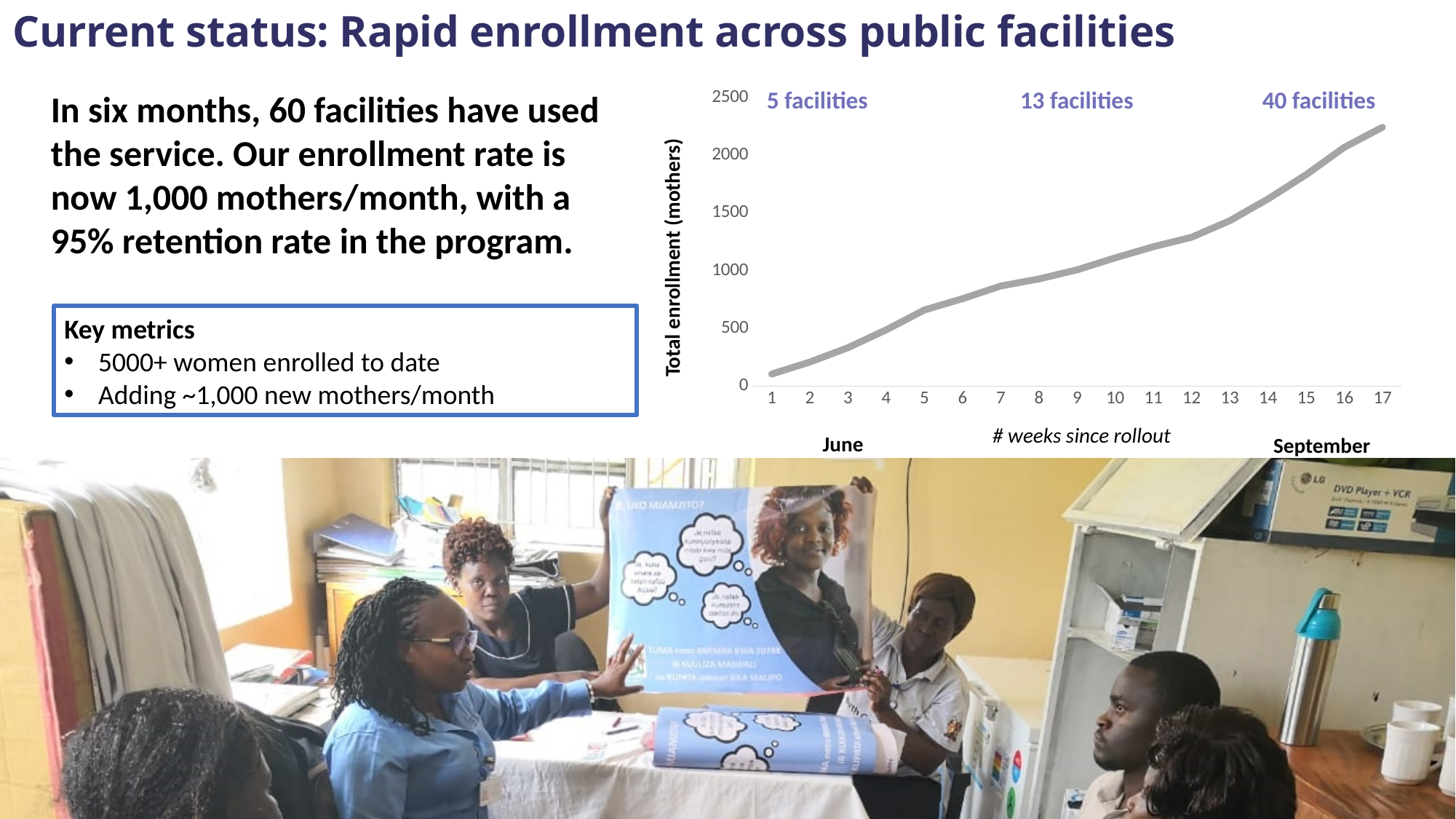
Does total enrollment rise or fall as the number of weeks since rollout increases? rise Is the total enrollment at week 1 greater or less than 500? less How many facilities does the annotation above the right end of the line indicate? 40 facilities What is the label of the chart's y axis? Total enrollment (mothers) Is the total enrollment at week 17 greater or less than 2000? greater What kind of chart is shown on the slide? line chart At which week is total enrollment highest? 17 Is the total enrollment at week 12 greater or less than 1000? greater How many weeks are plotted along the x axis of the chart? 17 At which week is total enrollment lowest? 1